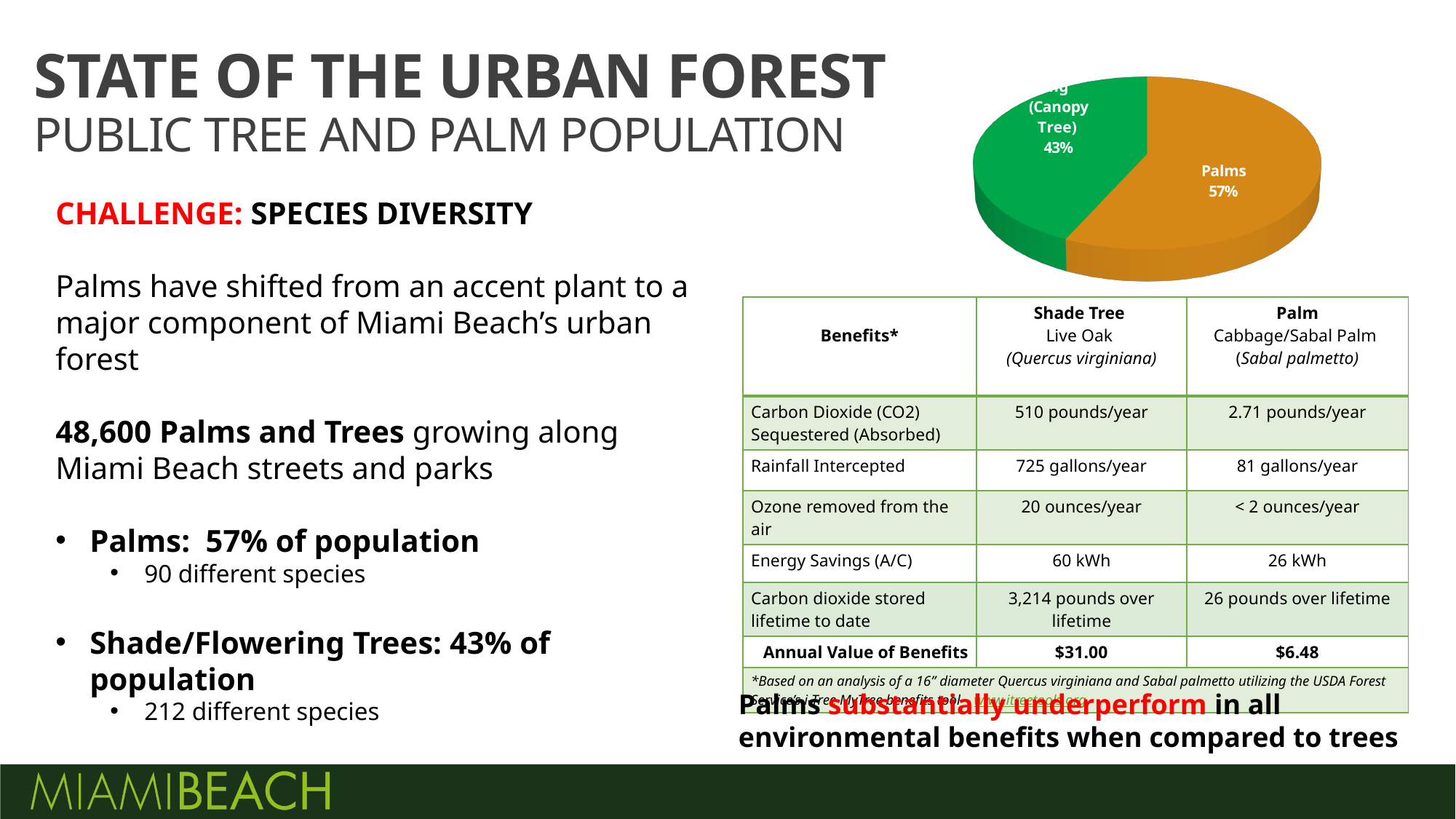
What is the difference in percentage points between the Palms slice and the Canopy Tree slice in the pie chart? 14 How many slices does the pie chart have? 2 In the pie chart, what share of the population is the Canopy Tree slice? 43% What colour is the Canopy Tree slice in the pie chart? green Which slice of the pie chart is the smallest? Canopy Tree What kind of chart is shown at the top right of the slide? pie chart Which slice of the pie chart is the largest? Palms In the pie chart, is the Palms slice larger or smaller than the Canopy Tree slice? larger What colour is the Palms slice in the pie chart? orange In the pie chart, what share of the population is Palms? 57% Is the Palms share in the pie chart greater or less than 50%? greater